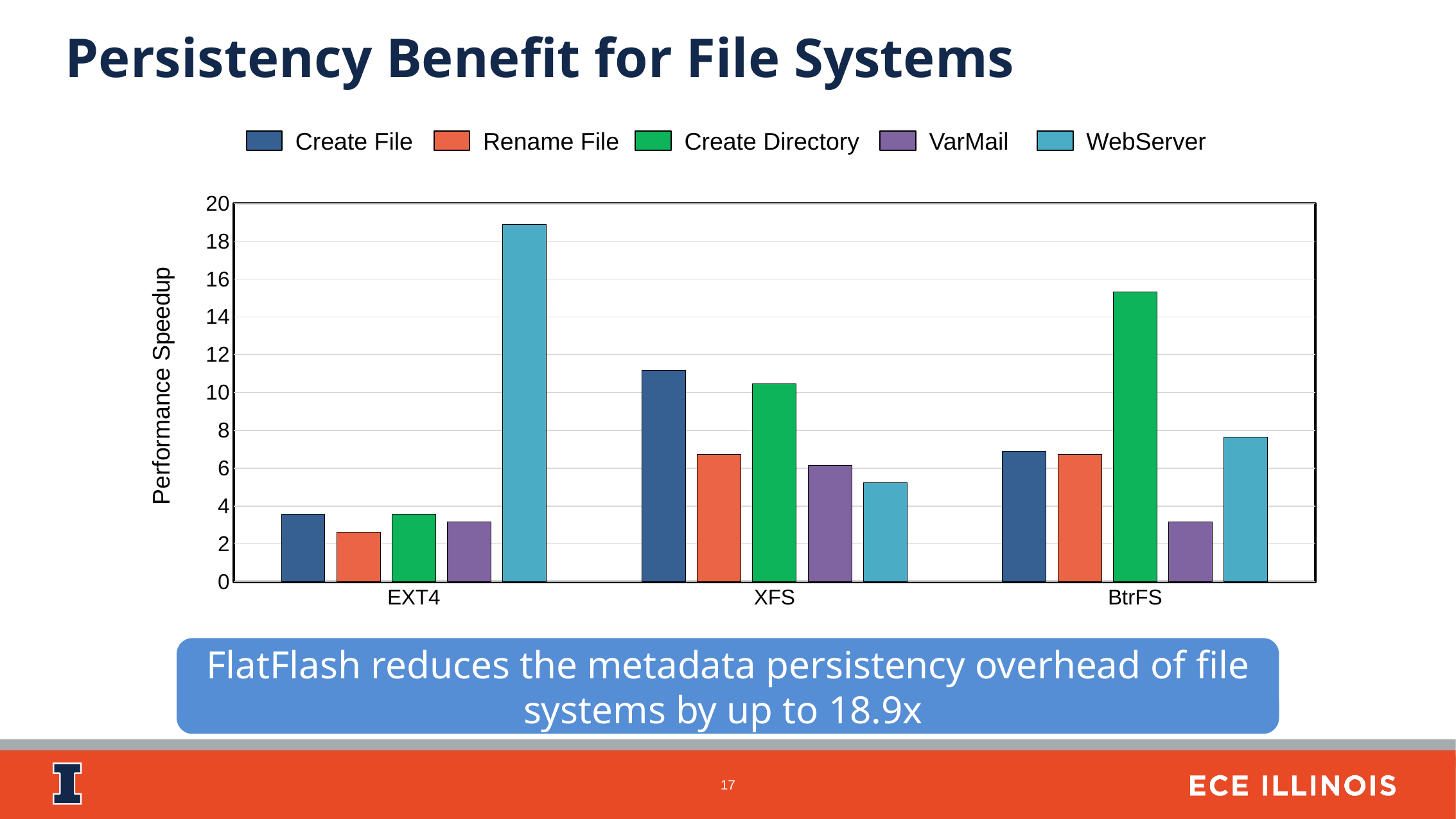
Is the Rename File speedup for EXT4 greater or less than 4? less Is the Create Directory speedup for BtrFS greater or less than 14? greater For EXT4, which workload has the lowest performance speedup? Rename File For BtrFS, which is larger: the Create File speedup or the Create Directory speedup? Create Directory Is the WebServer speedup for EXT4 greater or less than 18? greater For BtrFS, which workload has the highest performance speedup? Create Directory What is the label on the y axis of the chart? Performance Speedup What kind of chart is shown on the slide? bar chart For which file system is the WebServer speedup highest? EXT4 How many file systems are shown on the x axis? 3 How many series does the legend list? 5 For XFS, which workload has the lowest performance speedup? WebServer